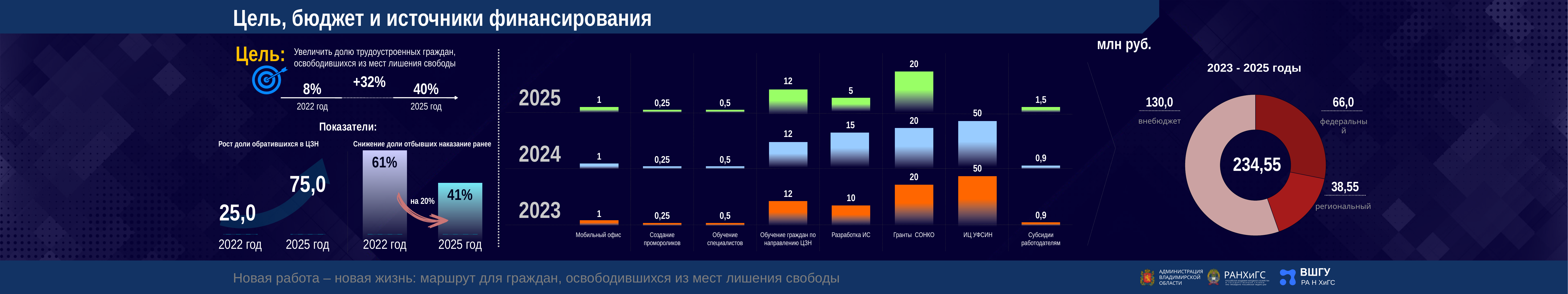
How many spending categories are shown along the bottom of the budget bar chart (млн руб.)? 8 In the budget bar chart (млн руб.), what is the difference between the Разработка ИС values for 2024 and 2023? 5 In the budget bar chart (млн руб.), what is the value for Разработка ИС in 2024? 15 In the budget bar chart (млн руб.), what is the value for ИЦ УФСИН in 2023? 50 In the chart 'Рост доли обратившихся в ЦЗН', what is the value for 2025 год? 75,0 In the chart 'Снижение доли отбывших наказание ранее', what is the value for 2025 год? 41% In the budget bar chart (млн руб.), is the Субсидии работодателям value larger in 2025 or in 2024? 2025 In the donut chart titled '2023 - 2025 годы', what total is shown in the centre? 234,55 In the donut chart titled '2023 - 2025 годы', what is the value for внебюджет? 130,0 In the budget bar chart (млн руб.), which category has the highest value in the 2025 row? Гранты СОНКО What kind of chart is the one titled '2023 - 2025 годы' on the right of the slide? Donut (pie) chart In the donut chart titled '2023 - 2025 годы', which funding source has the largest value? внебюджет